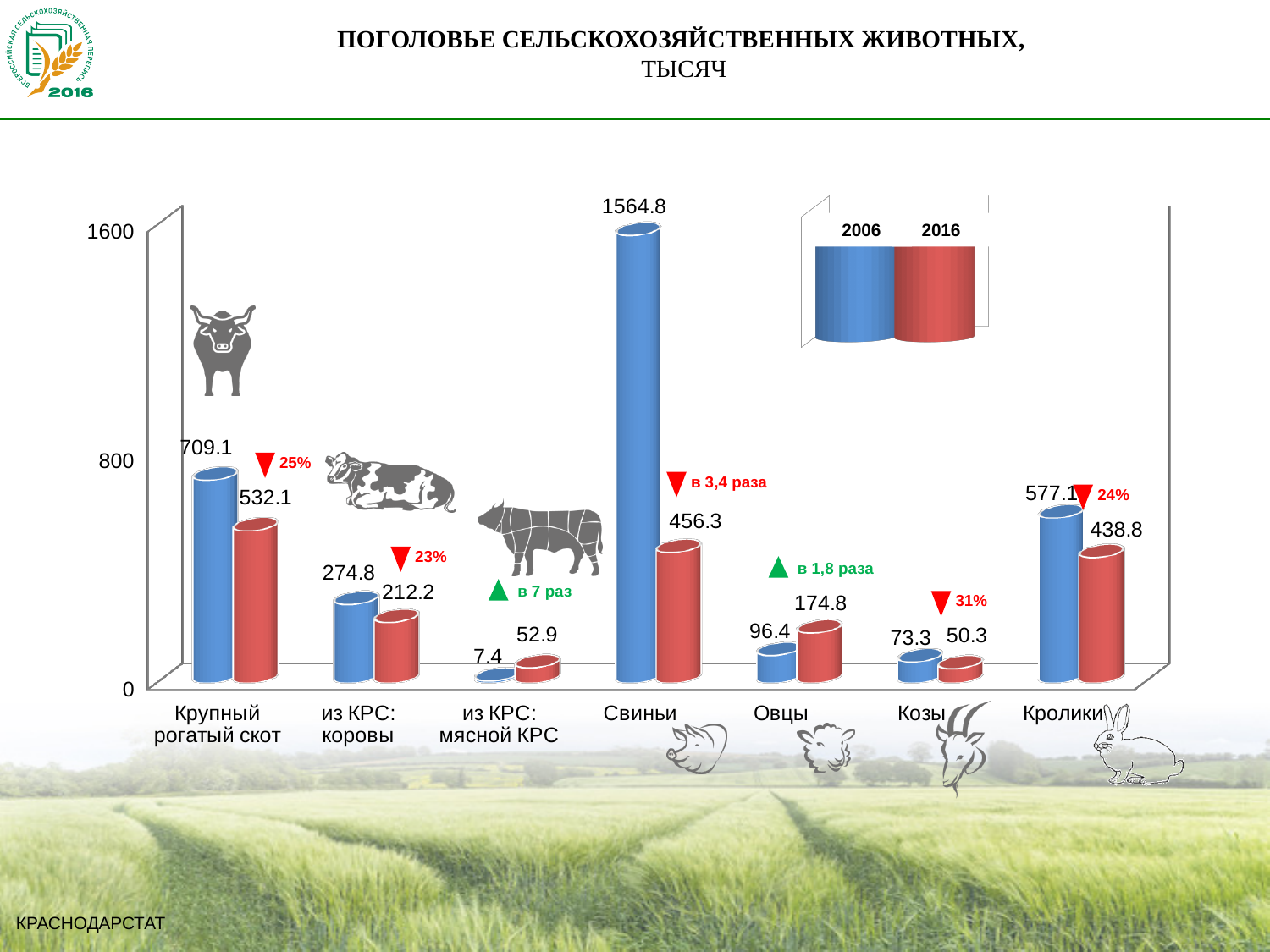
Which category had the lowest value in 2006? из КРС: мясной КРС Which colour represents the year 2016 in the legend? Red How many animal categories are shown on the x axis? 7 How many series does the legend list? 2 What is the difference between the 2006 and 2016 values for Крупный рогатый скот? 177.0 Which is larger for Козы: the 2006 value or the 2016 value? 2006 What kind of chart is shown on the slide? Bar chart Which category had the highest value in 2006? Свиньи What was the number of sheep (Овцы) in 2006, in thousands? 96.4 What was the number of rabbits (Кролики) in 2016, in thousands? 438.8 Which is larger for Овцы: the 2006 value or the 2016 value? 2016 What was the number of pigs (Свиньи) in 2006, in thousands? 1564.8